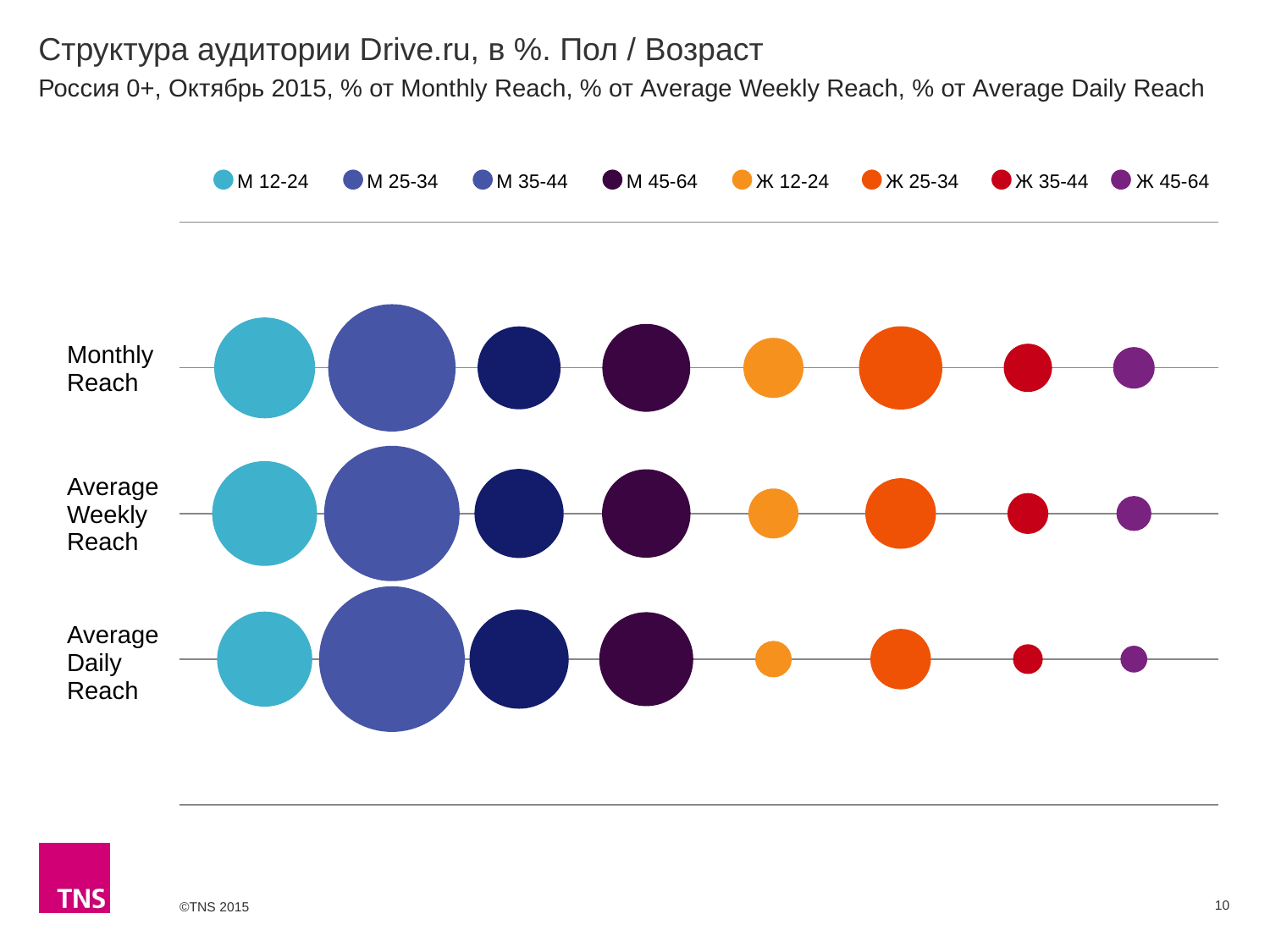
In the Monthly Reach row, which bubble is larger: М 12-24 or Ж 12-24? М 12-24 In the Average Daily Reach row, which bubble is larger: М 45-64 or Ж 12-24? М 45-64 What is the title of the chart on the slide? Структура аудитории Drive.ru, в %. Пол / Возраст What kind of chart is shown on the slide? Bubble chart In the Average Weekly Reach row, which bubble is larger: Ж 25-34 or Ж 35-44? Ж 25-34 Which audience group has the smallest bubble in the Average Daily Reach row? Ж 45-64 Which audience group has the largest bubble in the Monthly Reach row? М 25-34 Which audience group has the largest bubble in the Average Daily Reach row? М 25-34 How many reach categories (rows) are plotted on the chart? 3 Which audience group has the smallest bubble in the Monthly Reach row? Ж 45-64 What colour is the bubble for the Ж 25-34 series? Orange How many series does the legend list? 8